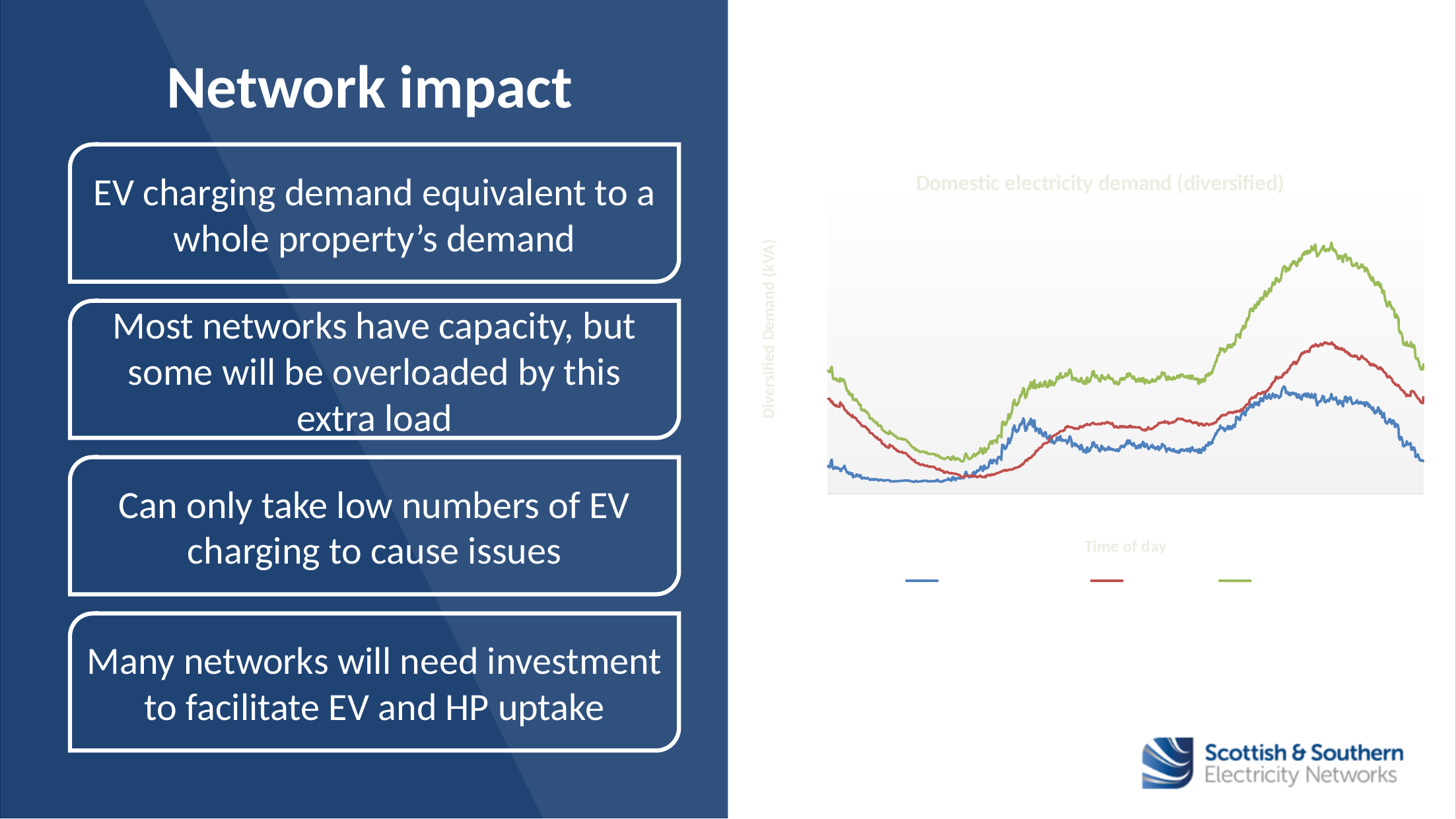
Does the green line rise or fall towards the right-hand end of the chart after its peak? fall How many series does the chart's legend list? 3 What is the title of the chart? Domestic electricity demand (diversified) Which coloured line reaches the highest peak on the chart? green What is the label on the chart's x axis? Time of day Which coloured line stays lowest across most of the chart? blue What kind of chart is shown on the slide? line chart At its peak, is the green line higher or lower than the red line? higher